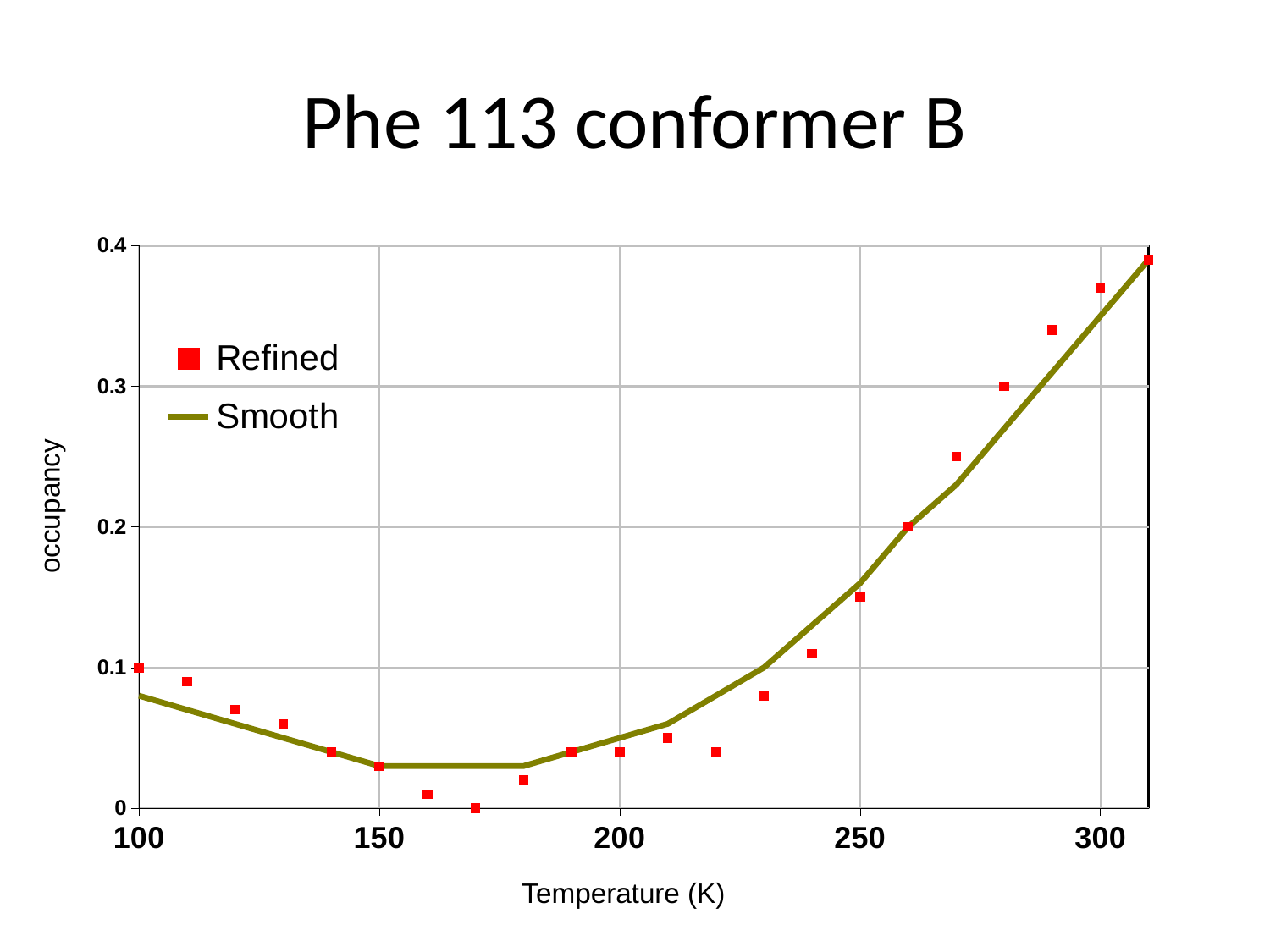
At which temperature is the Refined occupancy lowest? 170 K What is the Refined occupancy at 170 K? 0 Does the Smooth line rise or fall between 200 K and 310 K? rise What is the Refined occupancy at 100 K? 0.1 What is the Refined occupancy at 280 K? 0.3 What is the title of the chart? Phe 113 conformer B How many series does the legend list? 2 Which is larger, the Refined occupancy at 110 K or at 290 K? 290 K Is the Refined occupancy at 250 K greater or less than 0.2? less What kind of chart is shown on the slide? line chart At which temperature is the Refined occupancy highest? 310 K What is the label of the x axis? Temperature (K)